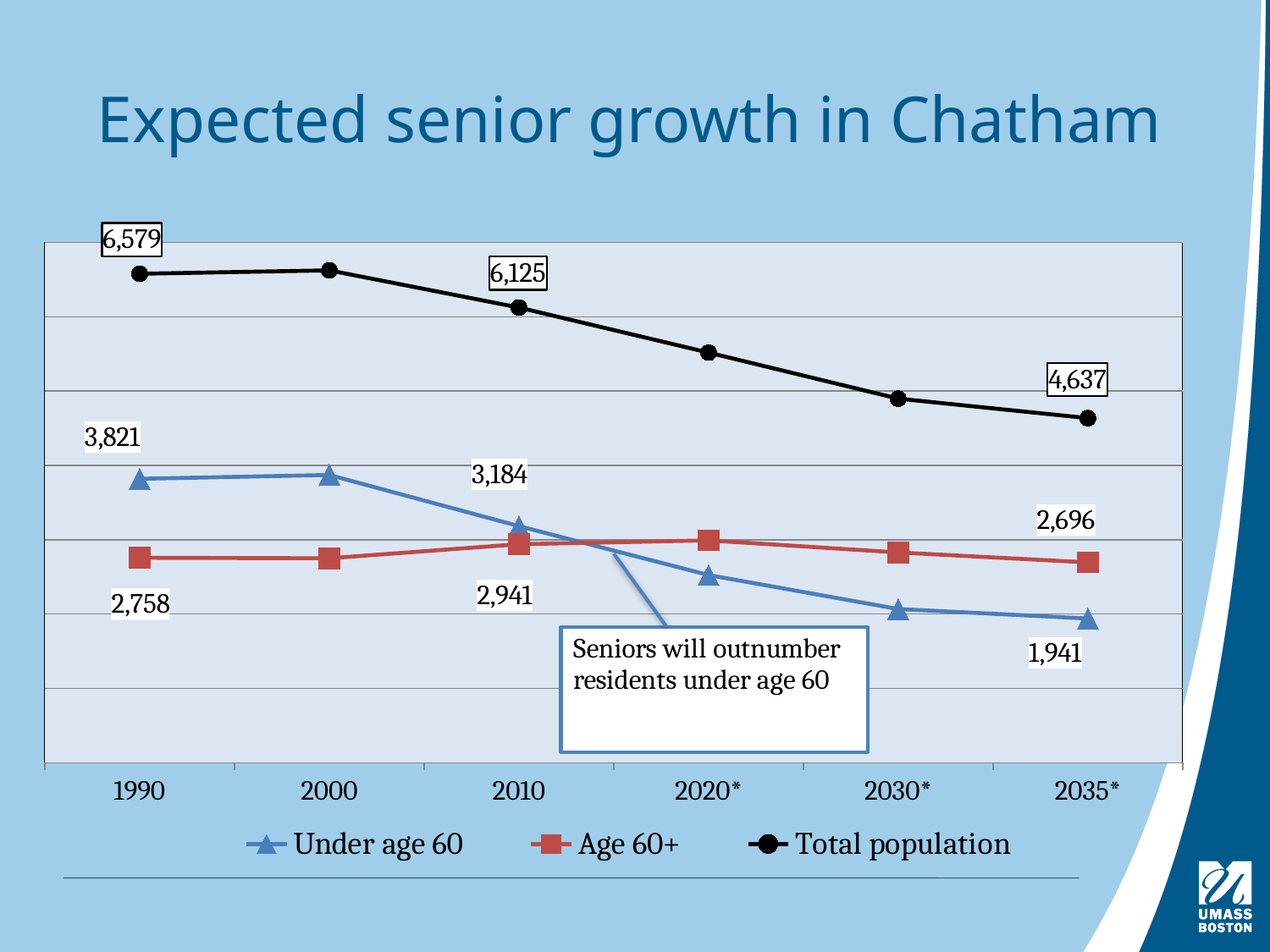
How many series does the legend list? 3 What is the total population value for 2035*? 4,637 What is the total population value for 1990? 6,579 What type of chart is shown on the slide? line chart What is the Under age 60 value for 1990? 3,821 What is the total population value for 2010? 6,125 Does the total population rise or fall from 2000 to 2035*? fall Which is larger in 2035*, the Age 60+ value or the Under age 60 value? Age 60+ What is the Age 60+ value for 2035*? 2,696 What is the title of the chart? Expected senior growth in Chatham How many years are shown on the x axis? 6 What is the difference between the Under age 60 value in 1990 and in 2035*? 1,880